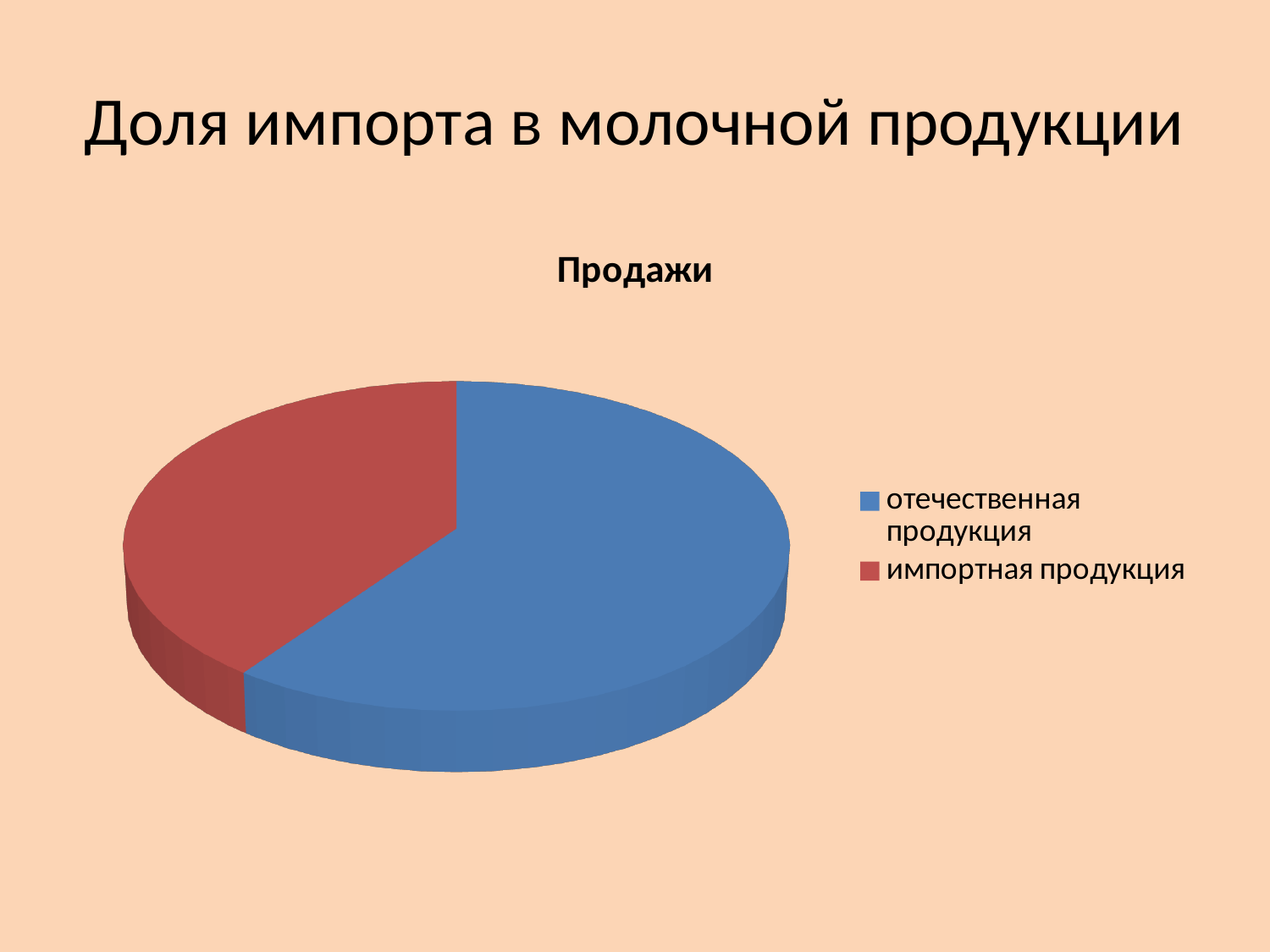
How many slices does the pie chart have? 2 How many entries does the legend of the pie chart list? 2 Which category has the largest slice in the pie chart? отечественная продукция What is the title of the pie chart? Продажи What colour is the slice for импортная продукция? red Which slice is larger: отечественная продукция or импортная продукция? отечественная продукция Does отечественная продукция account for more or less than half of the pie? more Which category has the smallest slice in the pie chart? импортная продукция What kind of chart is shown on the slide? pie chart